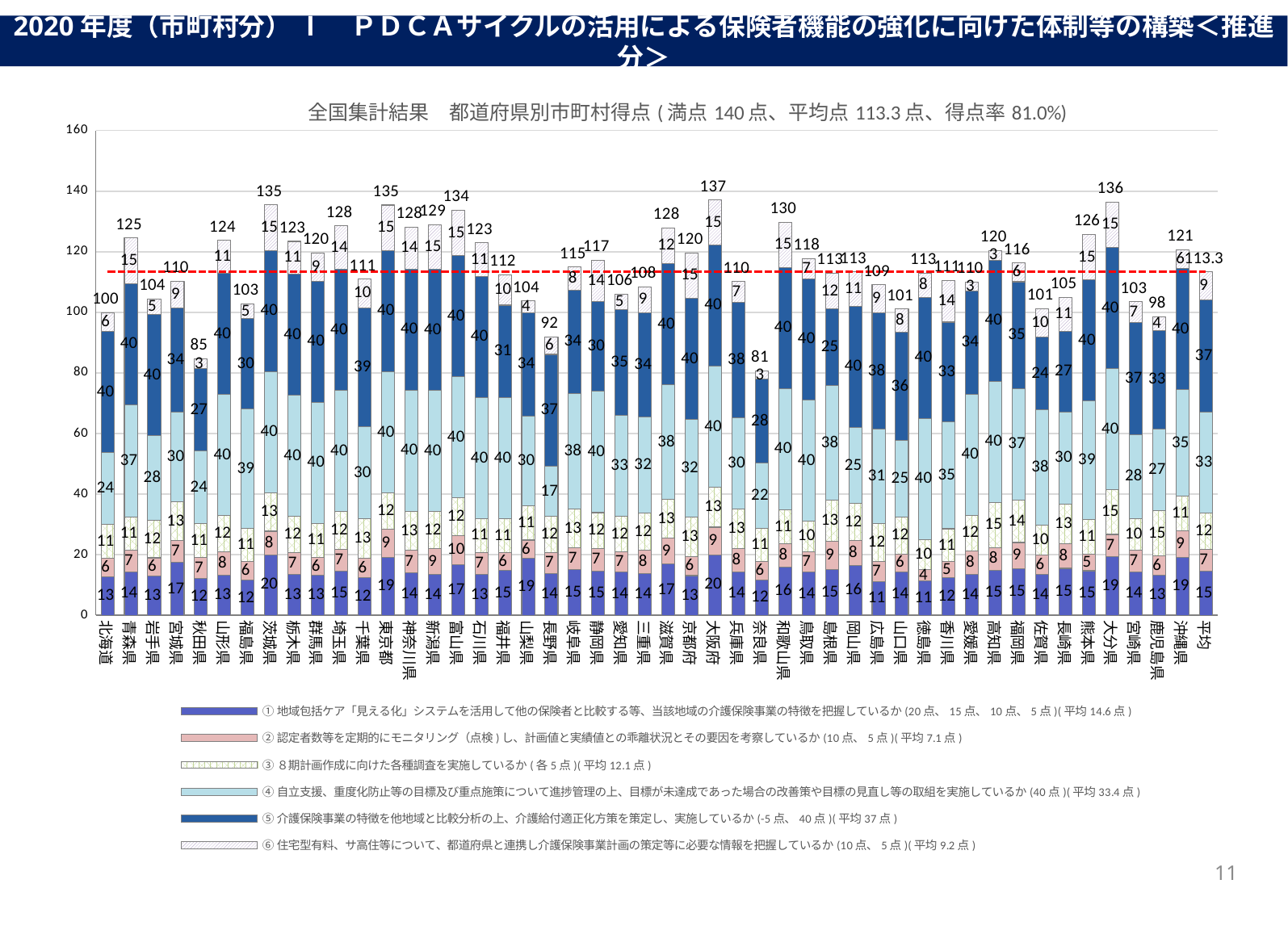
Is the total score for 秋田県 greater or less than 100? less What is the value of the 平均 (average) bar at the far right? 113.3 How many series does the legend list? 6 Which prefecture has the lowest total score? 奈良県 What is the 満点 (full score) stated in the chart title? 140 点 What is the total score shown for 奈良県? 81 What kind of chart is shown on the slide? stacked bar chart Which has a higher total score, 青森県 or 岩手県? 青森県 What is the total score shown for 北海道? 100 Which prefecture has the highest total score? 大阪府 What is the total score shown for 大阪府? 137 What is the difference between the total scores of 大阪府 and 奈良県? 56